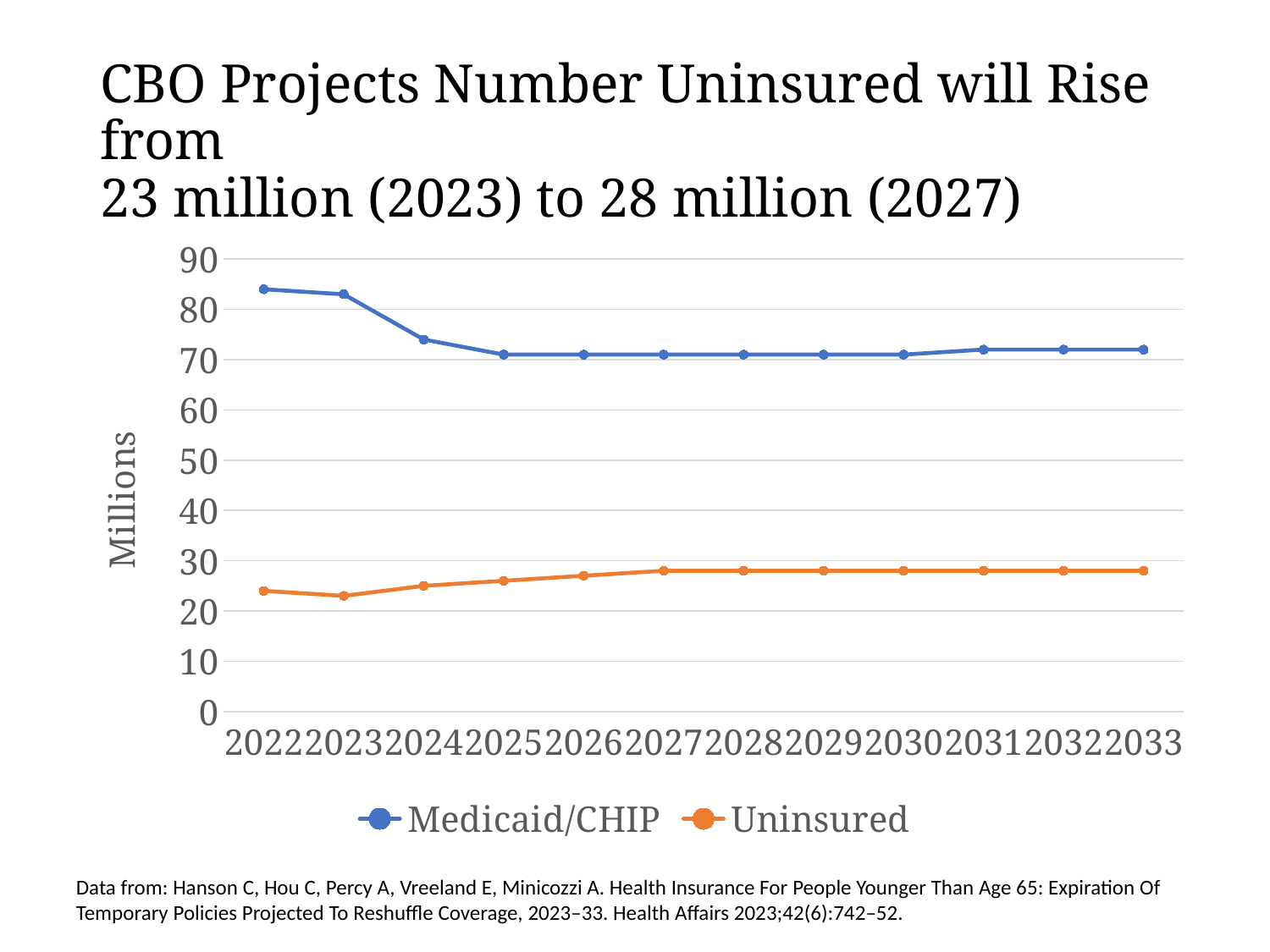
How many years are plotted along the x axis? 12 Is the Uninsured value for 2030 greater or less than 30? less In 2022, which series has the larger value, Medicaid/CHIP or Uninsured? Medicaid/CHIP Is the Medicaid/CHIP value for 2022 greater or less than 80? greater Does the Medicaid/CHIP line rise or fall between 2022 and 2025? fall What is the label on the vertical axis? Millions Which series is drawn in orange? Uninsured How many series does the legend list? 2 Is the Medicaid/CHIP value for 2033 greater or less than 80? less According to the slide, what is the projected number of uninsured in 2023? 23 million What kind of chart is shown on the slide? line chart According to the slide, what is the projected number of uninsured in 2027? 28 million